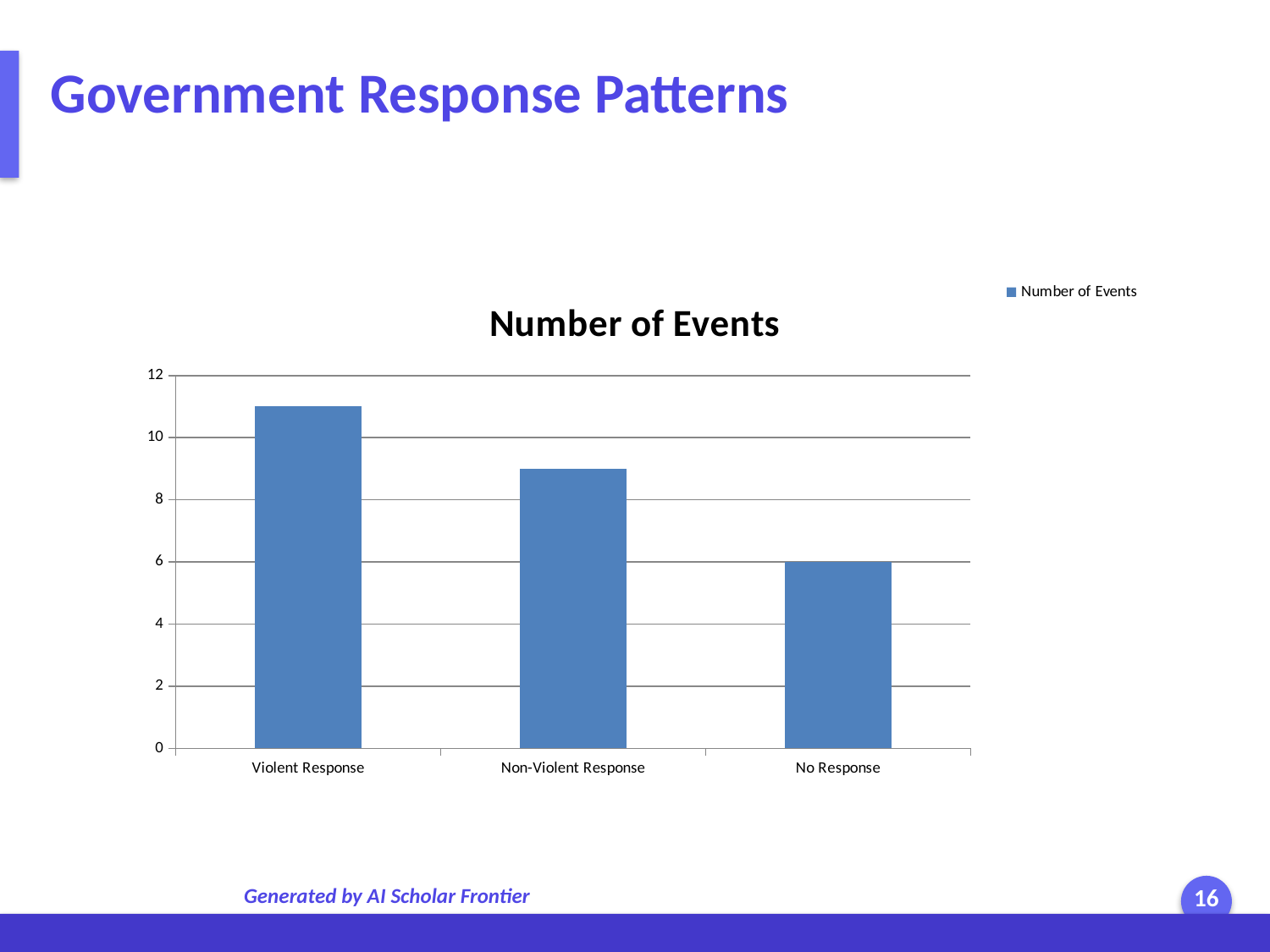
Which category has the lowest number of events? No Response What kind of chart is shown on the slide? bar chart Which category has the highest number of events? Violent Response How many categories are shown on the x axis of the chart? 3 How many series does the legend list? 1 Which is larger, the value for Non-Violent Response or the value for No Response? Non-Violent Response Do the values rise or fall from left to right along the x axis? fall Is the value for Non-Violent Response greater or less than 10? less What is the title of the chart? Number of Events Is the value for Non-Violent Response greater or less than 8? greater Is the value for Violent Response greater or less than 10? greater What is the value for No Response? 6